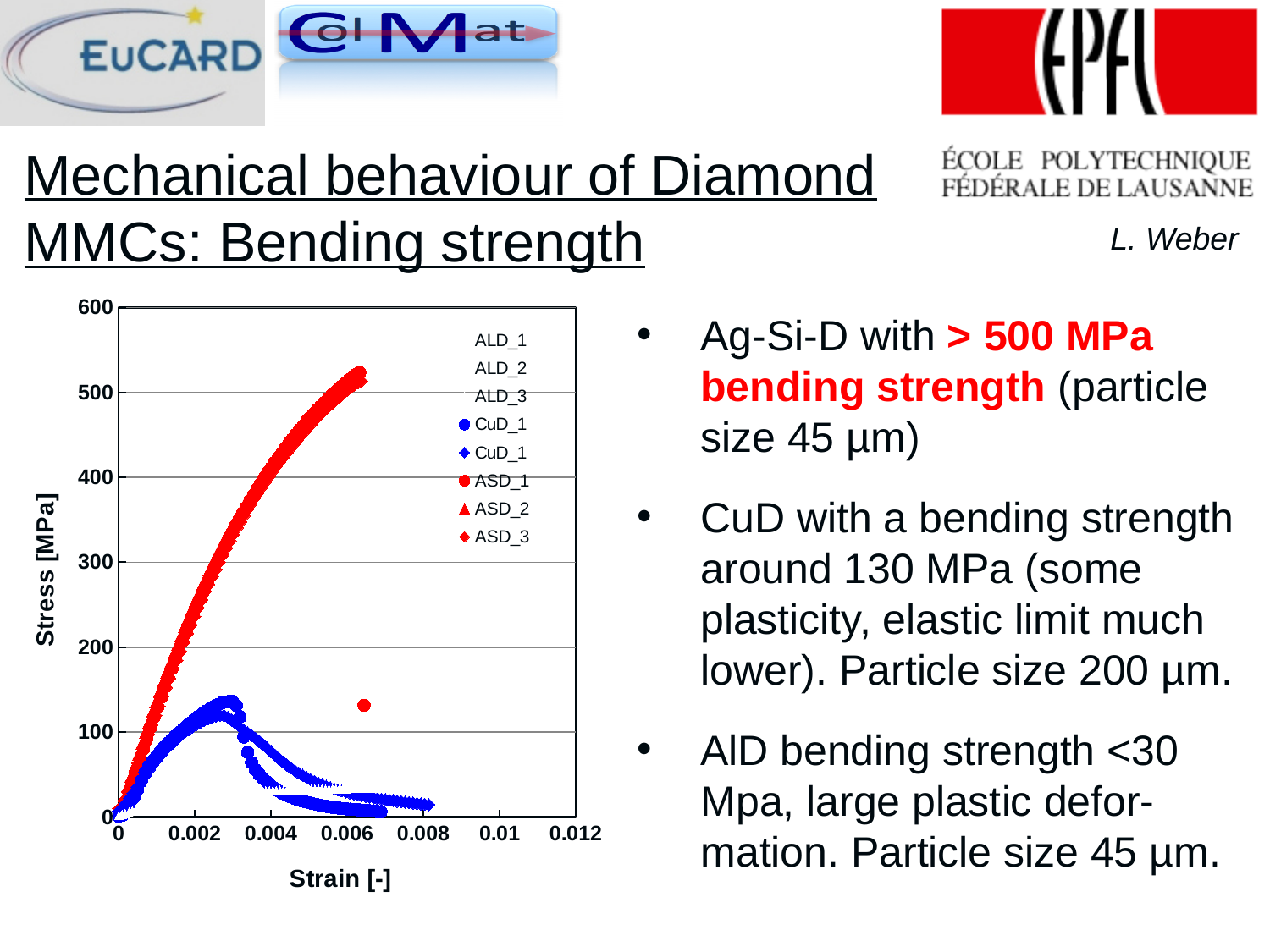
What is the highest value shown on the y axis of the chart? 600 What is the label of the x axis of the chart? Strain [-] Is the peak stress reached by the blue CuD curves greater or less than 200 MPa? less What kind of chart is shown on the slide? scatter chart Does the stress of the red ASD curves rise or fall as strain increases from 0 to 0.006? rise Which reaches a higher peak stress, the red ASD curves or the blue CuD curves? the red ASD curves Is the peak stress reached by the blue CuD curves greater or less than 100 MPa? greater What is the label of the y axis of the chart? Stress [MPa] Is the peak stress reached by the red ASD curves greater or less than 500 MPa? greater How many series does the chart legend list? 8 Does the stress of the blue CuD curves rise or fall as strain increases from 0.003 to 0.006? fall